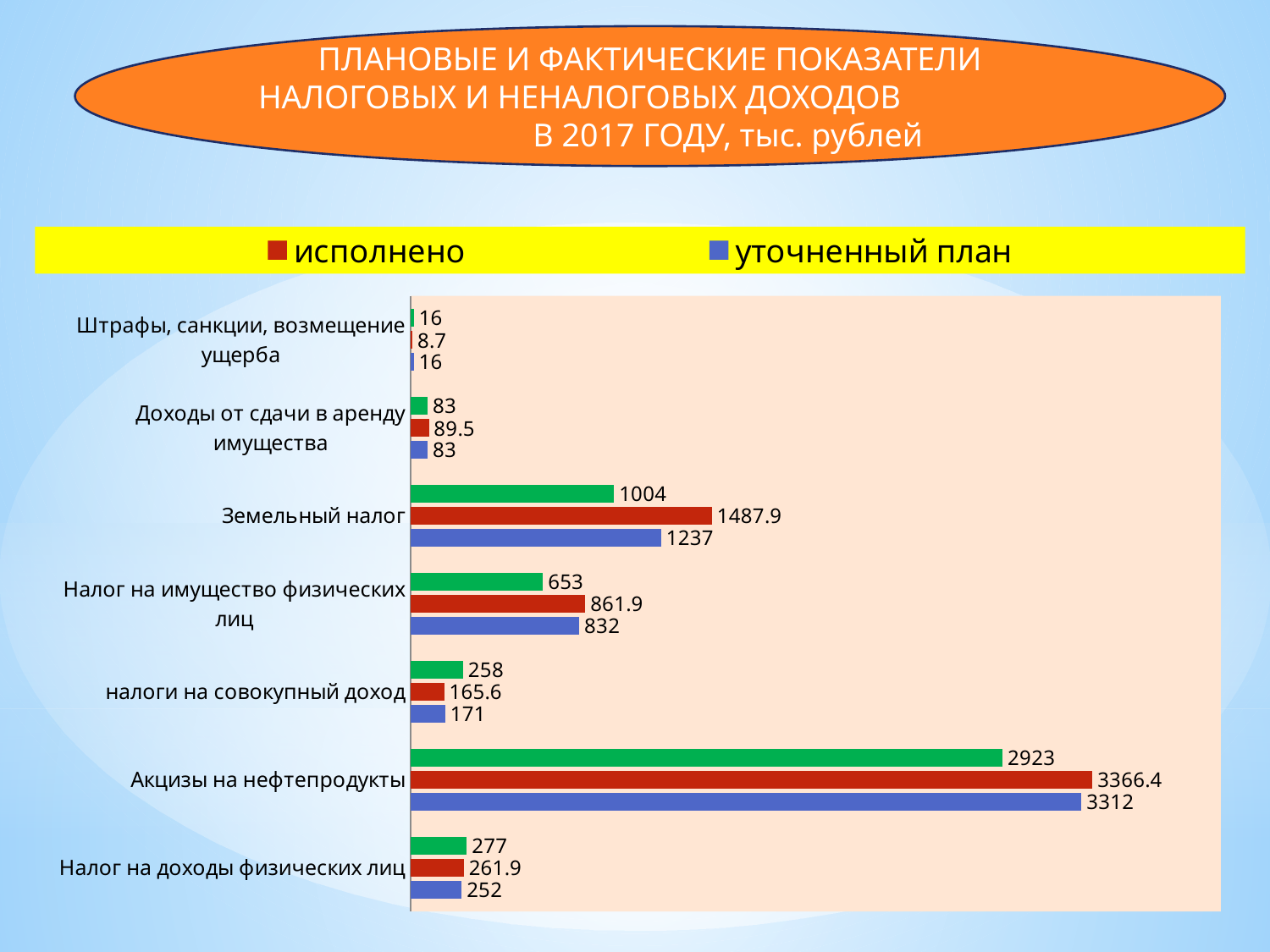
What is the value of "исполнено" for "Штрафы, санкции, возмещение ущерба"? 8.7 What is the value of "уточненный план" for "Акцизы на нефтепродукты"? 3312 What type of chart is shown on the slide? bar chart Which colour represents "уточненный план" in the legend? blue Which category has the lowest "уточненный план" value? Штрафы, санкции, возмещение ущерба Which is larger for "налоги на совокупный доход": "исполнено" or "уточненный план"? уточненный план Which category has the highest "исполнено" value? Акцизы на нефтепродукты What is the difference between "исполнено" and "уточненный план" for "Земельный налог"? 250.9 How many series does the legend list? 2 What is the value of "исполнено" for "Земельный налог"? 1487.9 How many categories are shown on the chart? 7 What is the value of "уточненный план" for "Налог на имущество физических лиц"? 832